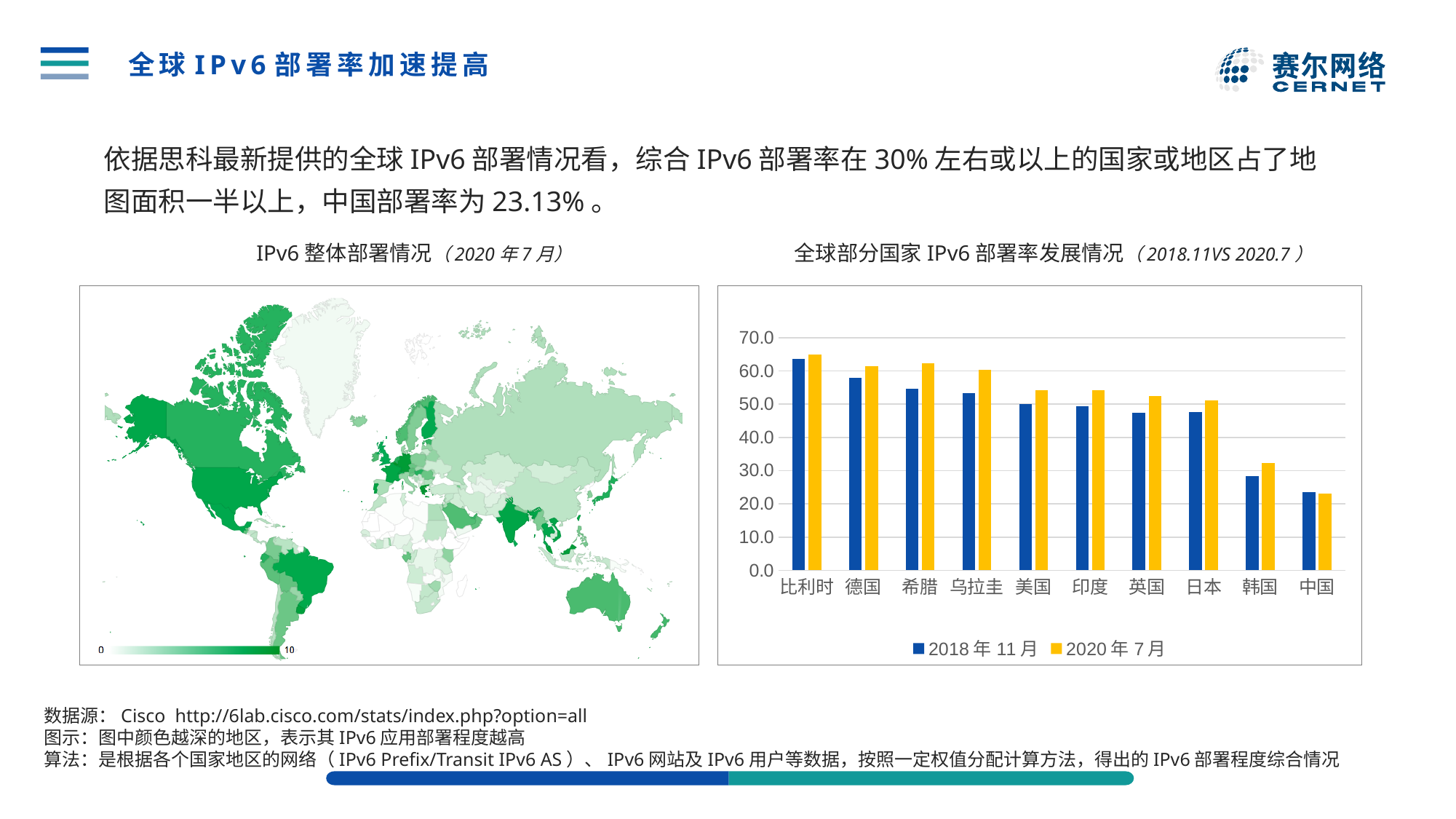
In the right-hand bar chart, how many series does the legend list? 2 In the right-hand bar chart, which is larger for 2020 年 7 月: 韩国 or 中国? 韩国 What kind of chart is the right-hand chart titled 全球部分国家 IPv6 部署率发展情况? bar chart In the right-hand bar chart, do the 2020 年 7 月 values generally rise or fall from left to right along the x axis? fall In the right-hand bar chart, how many countries are shown on the x axis? 10 In the right-hand bar chart, which country has the lowest value for 2020 年 7 月? 中国 In the right-hand bar chart, which country has the highest value for 2020 年 7 月? 比利时 In the right-hand bar chart, is the 2018 年 11 月 value for 韩国 greater or less than 30.0? less In the right-hand bar chart, is the 2018 年 11 月 value for 比利时 greater or less than 60.0? greater In the right-hand bar chart, is the 2018 年 11 月 value for 乌拉圭 greater or less than 60.0? less In the right-hand bar chart, which is larger for 2020 年 7 月: 希腊 or 美国? 希腊 What are the two legend entries in the right-hand bar chart? 2018 年 11 月 and 2020 年 7 月